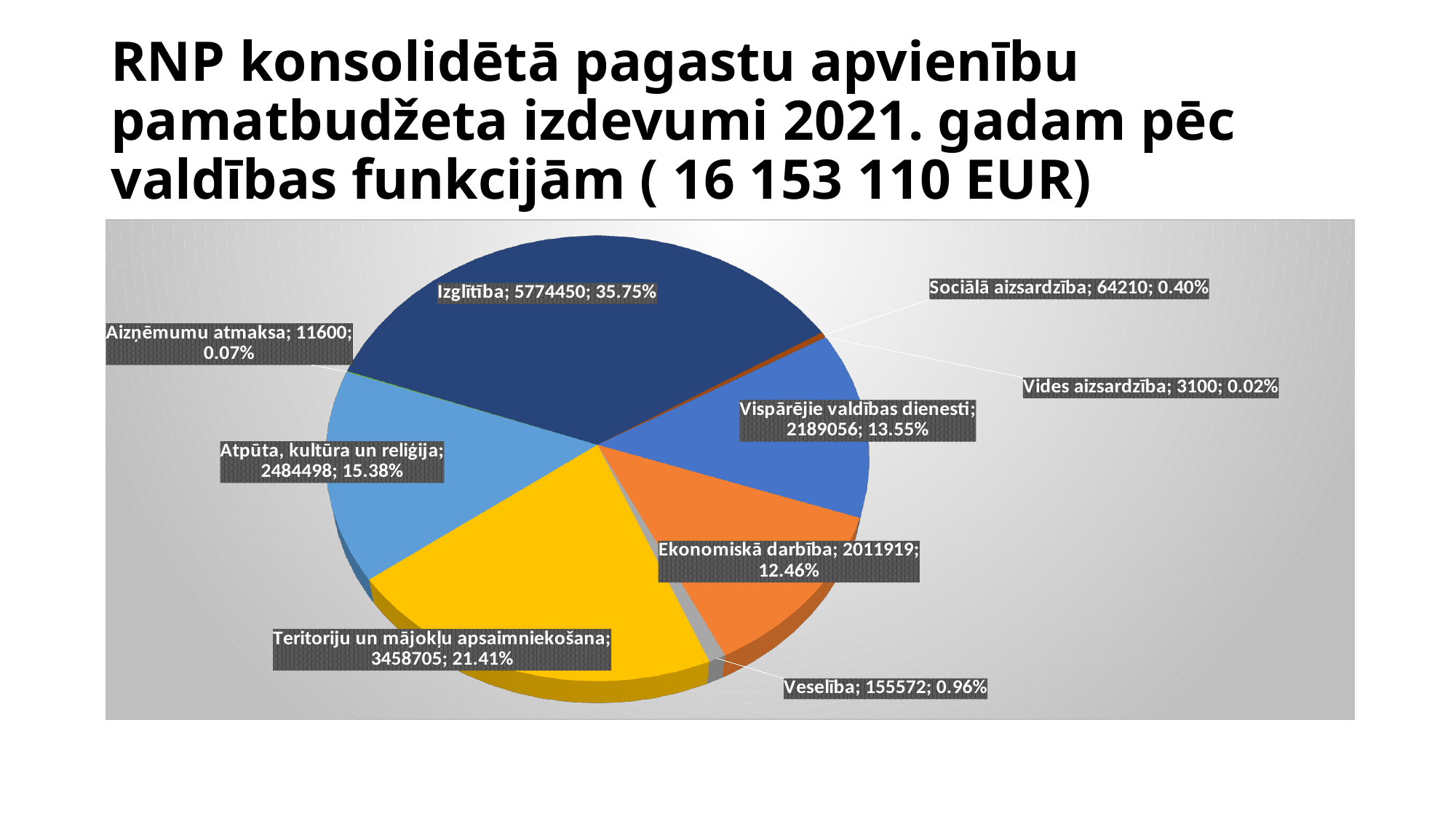
What is the difference between the values for Izglītība and Teritoriju un mājokļu apsaimniekošana? 2315745 What share of the pie does Teritoriju un mājokļu apsaimniekošana represent? 21.41% Which category has the smallest slice of the pie? Vides aizsardzība Which is larger: the value for Vispārējie valdības dienesti or the value for Ekonomiskā darbība? Vispārējie valdības dienesti What total amount in EUR is stated in the slide title? 16 153 110 EUR What is the value for Aizņēmumu atmaksa? 11600 What is the value for Vispārējie valdības dienesti? 2189056 What kind of chart is shown on the slide? pie chart Which category has the largest slice of the pie? Izglītība How many categories (slices) does the pie chart show? 9 What percentage is shown for Veselība? 0.96% What is the value for Izglītība? 5774450